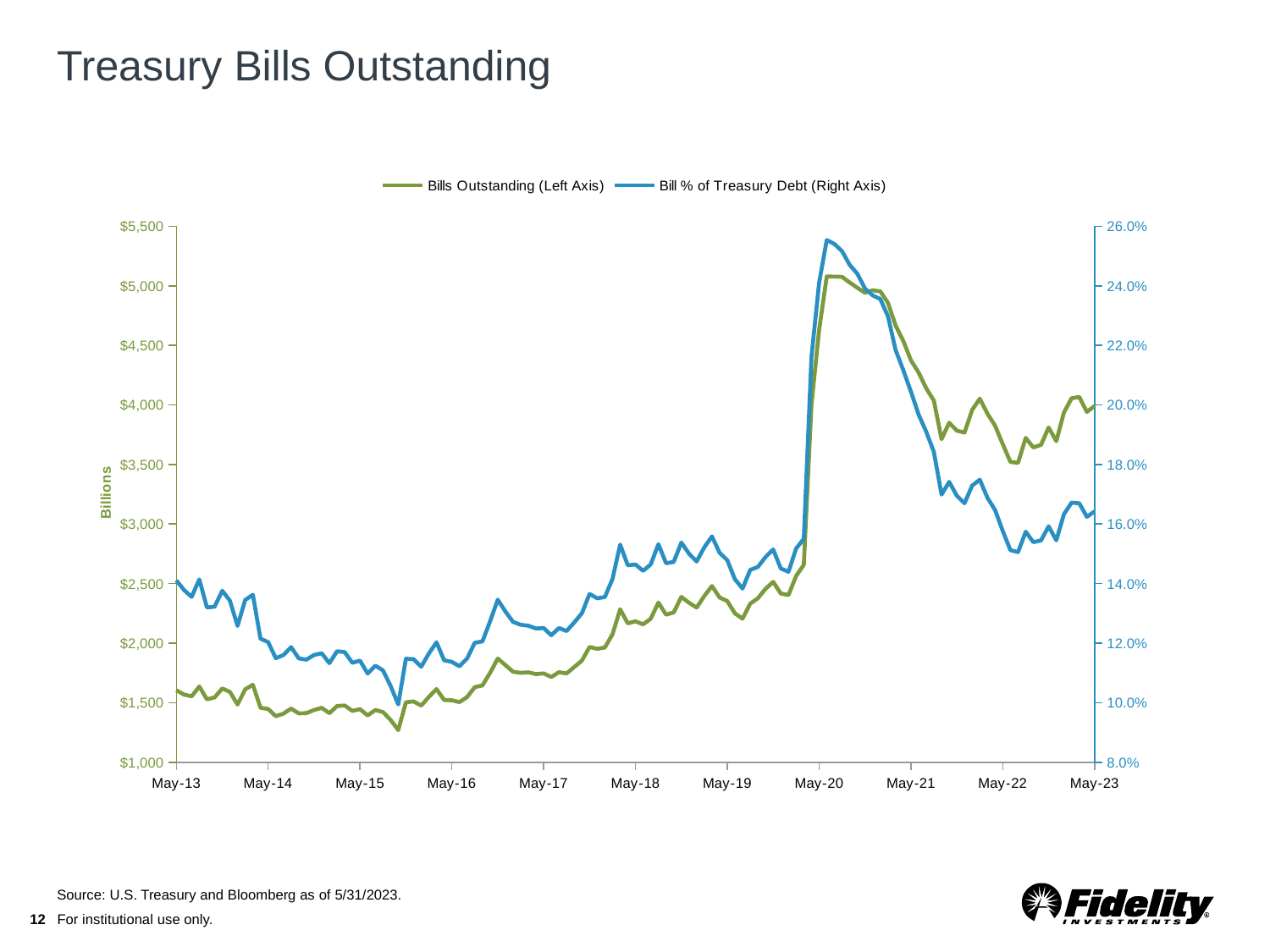
Is the value of Bills Outstanding at May-23 greater or less than $3,500? greater How many series does the legend list? 2 What type of chart is shown on the slide? Line chart Is the value of Bill % of Treasury Debt at May-15 greater or less than 14.0%? less Which is larger, Bills Outstanding at May-13 or at May-23? May-23 What is the label on the left vertical axis? Billions Does Bills Outstanding rise or fall overall between May-20 and May-22? Fall How many date labels are shown on the x axis? 11 What colour is the line for Bill % of Treasury Debt (Right Axis)? Blue Is the value of Bills Outstanding at May-13 greater or less than $2,000? less Near which x-axis label does Bills Outstanding reach its highest point? May-20